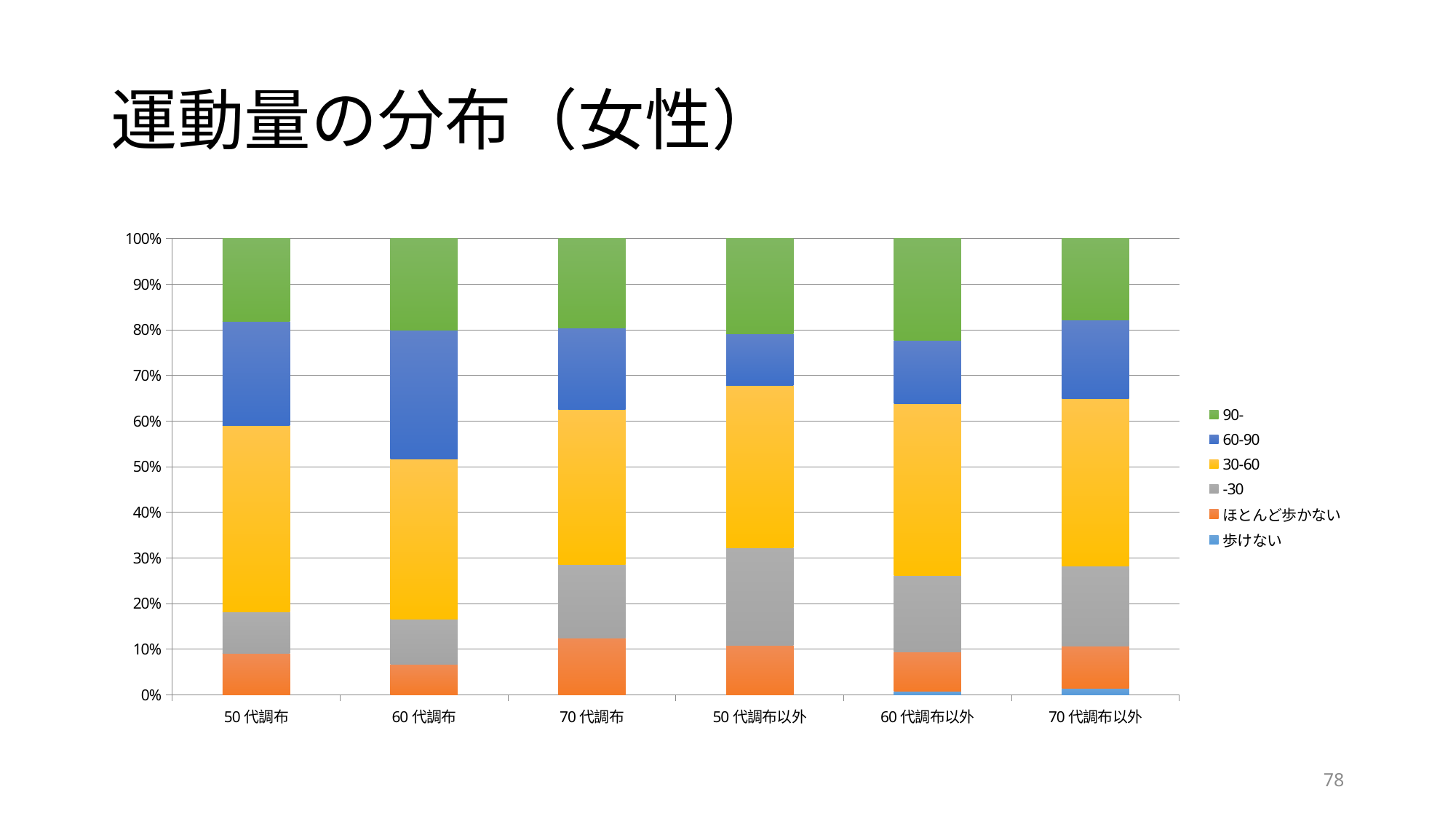
Is the 60-90 segment for 60代調布 greater or less than 20%? greater What is the total of the stacked bar for 50代調布? 100% Is the 90- segment for 50代調布 greater or less than 30%? less Is the ほとんど歩かない segment for 60代調布 greater or less than 10%? less What kind of chart is shown on the slide? Stacked bar chart Which has the larger 60-90 segment, 60代調布 or 50代調布以外? 60代調布 Which category has the largest -30 segment? 50代調布以外 How many series does the legend list? 6 What is the title of the slide? 運動量の分布（女性） Which category has the largest 60-90 segment? 60代調布 How many categories are shown along the x axis? 6